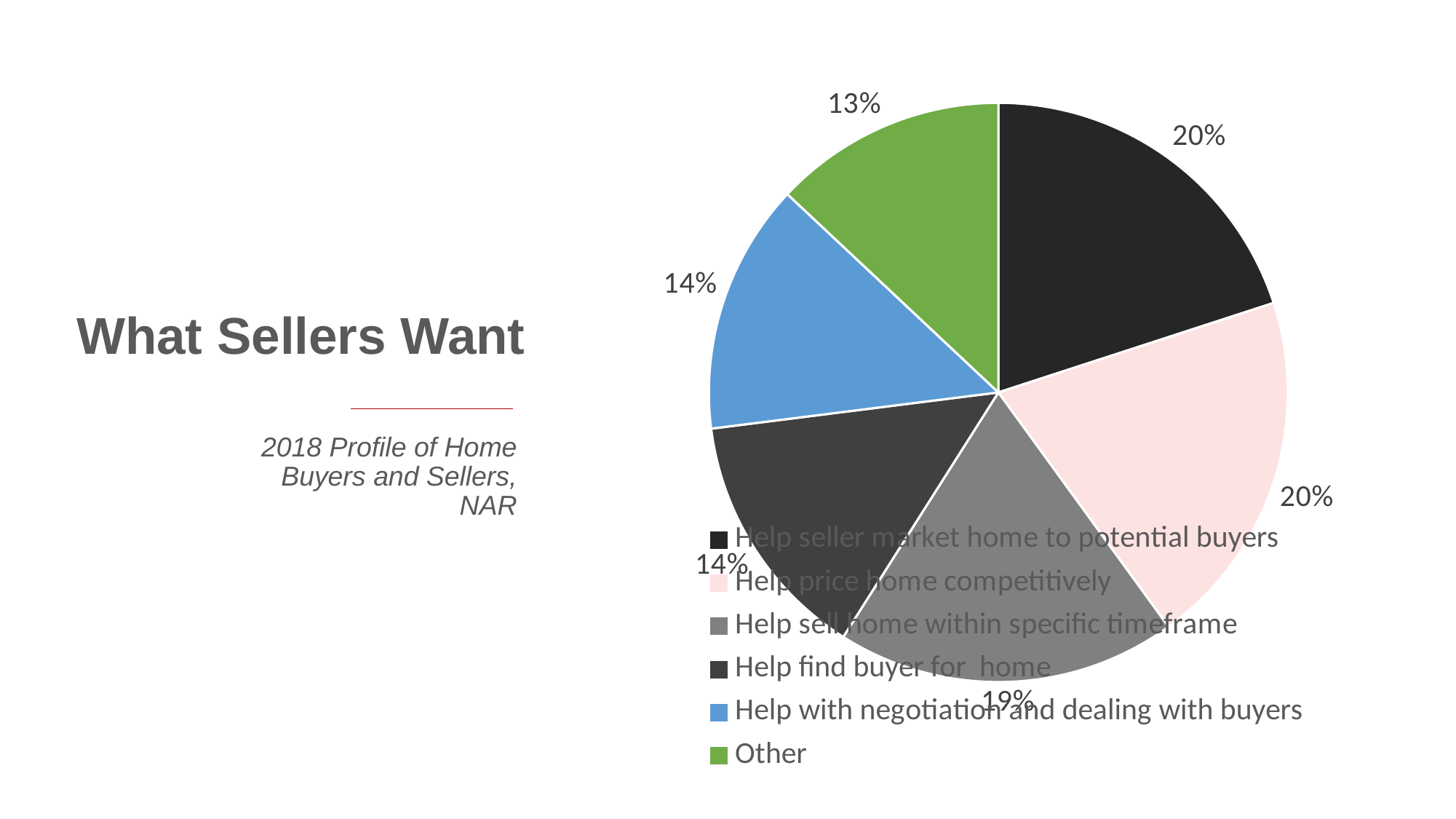
Which category has the smallest slice of the pie? Other What share of the pie is 'Help with negotiation and dealing with buyers'? 14% What is the difference in percentage points between 'Help price home competitively' and 'Other'? 7 Which is larger: 'Help sell home within specific timeframe' or 'Help find buyer for home'? Help sell home within specific timeframe How many slices does the pie chart have? 6 What kind of chart is shown on the slide? pie chart What share of the pie is 'Help seller market home to potential buyers'? 20% How many entries does the legend list? 6 What share of the pie is 'Other'? 13% What share of the pie is 'Help sell home within specific timeframe'? 19% What colour is the slice for 'Other'? green What share of the pie is 'Help price home competitively'? 20%